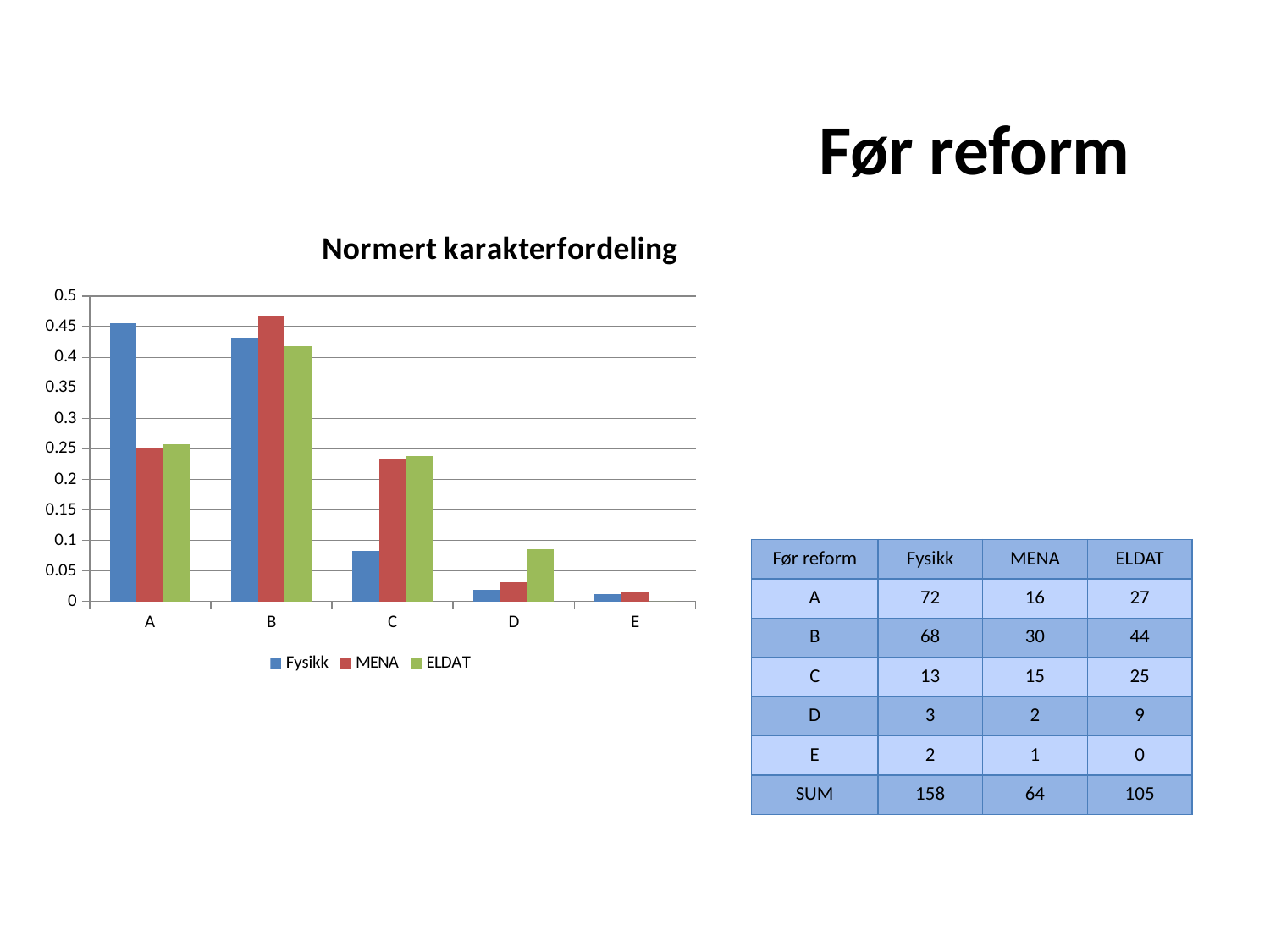
Which category has the highest MENA bar? B Which category has the lowest Fysikk bar? E Is the MENA value for A greater or less than 0.3? less Do the Fysikk values rise or fall from A to E? fall How many categories are shown on the x axis of the chart? 5 Which series has the highest bar for category A? Fysikk What kind of chart is shown on the slide? bar chart How many series does the chart's legend list? 3 What is the title of the chart? Normert karakterfordeling Which series has the highest bar for category D? ELDAT Which is larger for category C: the ELDAT value or the Fysikk value? ELDAT Is the Fysikk value for A greater or less than 0.4? greater